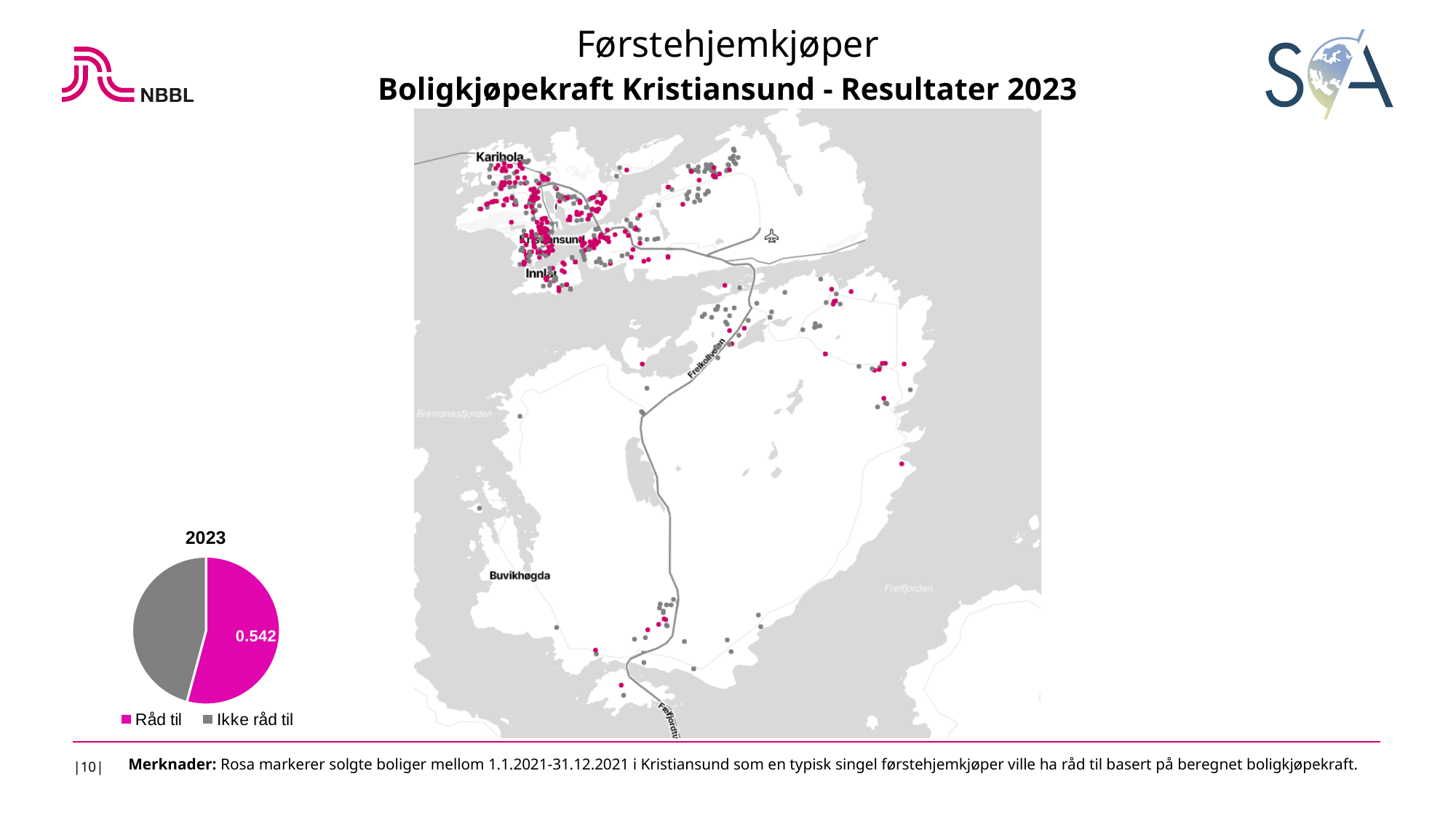
What colour is the "Råd til" slice in the pie chart? Pink What is the title shown above the pie chart? 2023 Which slice of the pie chart is the largest? Råd til In the pie chart, which is larger: "Råd til" or "Ikke råd til"? Råd til How many slices does the pie chart have? 2 How many entries does the pie chart's legend list? 2 In the pie chart, what value is shown for "Råd til"? 0.542 What kind of chart is shown at the bottom left of the slide? Pie chart Which slice of the pie chart is the smallest? Ikke råd til